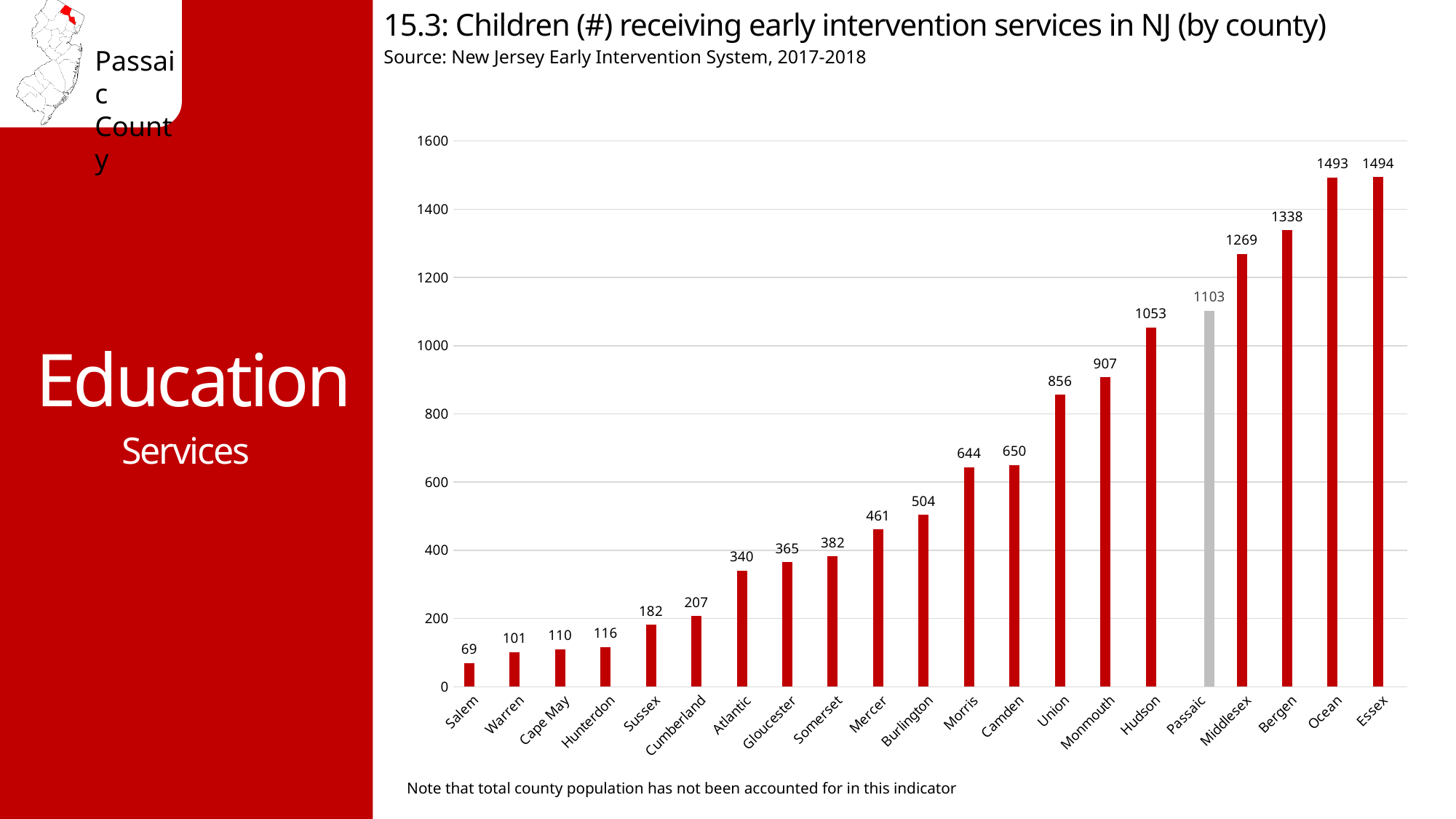
What type of chart is shown on the slide? bar chart How many children received early intervention services in Passaic County? 1103 What is the difference between the values for Essex and Ocean? 1 What is the value for Hudson County? 1053 Which county has the lowest number of children receiving early intervention services? Salem How many counties are shown on the chart? 21 What is the value for Cumberland County? 207 What is the difference between the values for Passaic and Middlesex? 166 Do the values generally rise or fall moving from left to right along the x axis? rise Which county's bar is shown in grey rather than red? Passaic Which county has a larger value, Union or Monmouth? Monmouth Is the value for Bergen greater or less than 1200? greater